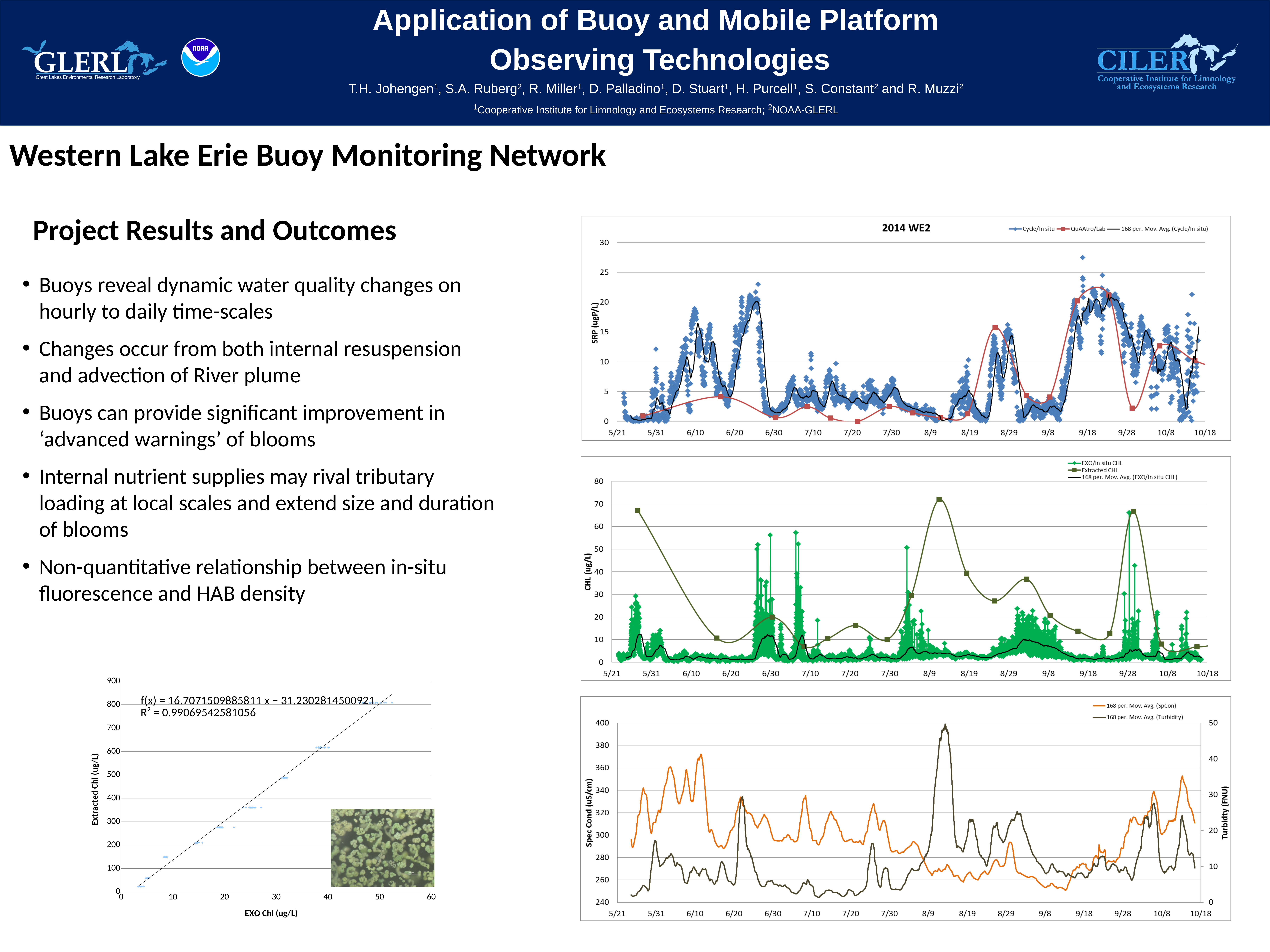
In the bottom-left scatter chart, what R² value is printed for the fitted line? 0.99069542581056 In the middle-right CHL chart, is the Extracted CHL value near 6/20 greater or less than 20? less In the bottom-right chart, is the peak Turbidity value (around 8/12) greater or less than 40? greater What kind of chart is the bottom-left chart of Extracted Chl versus EXO Chl? scatter chart In the 2014 WE2 chart, how many series does the legend list? 3 In the bottom-right chart, how many series does the legend list? 2 In the middle-right CHL chart, how many series does the legend list? 3 In the 2014 WE2 chart, is the QuAAtro/Lab value near 9/18 greater or less than 15? greater In the 2014 WE2 chart, what is the label on the y axis? SRP (ugP/L) What is the title of the top-right chart? 2014 WE2